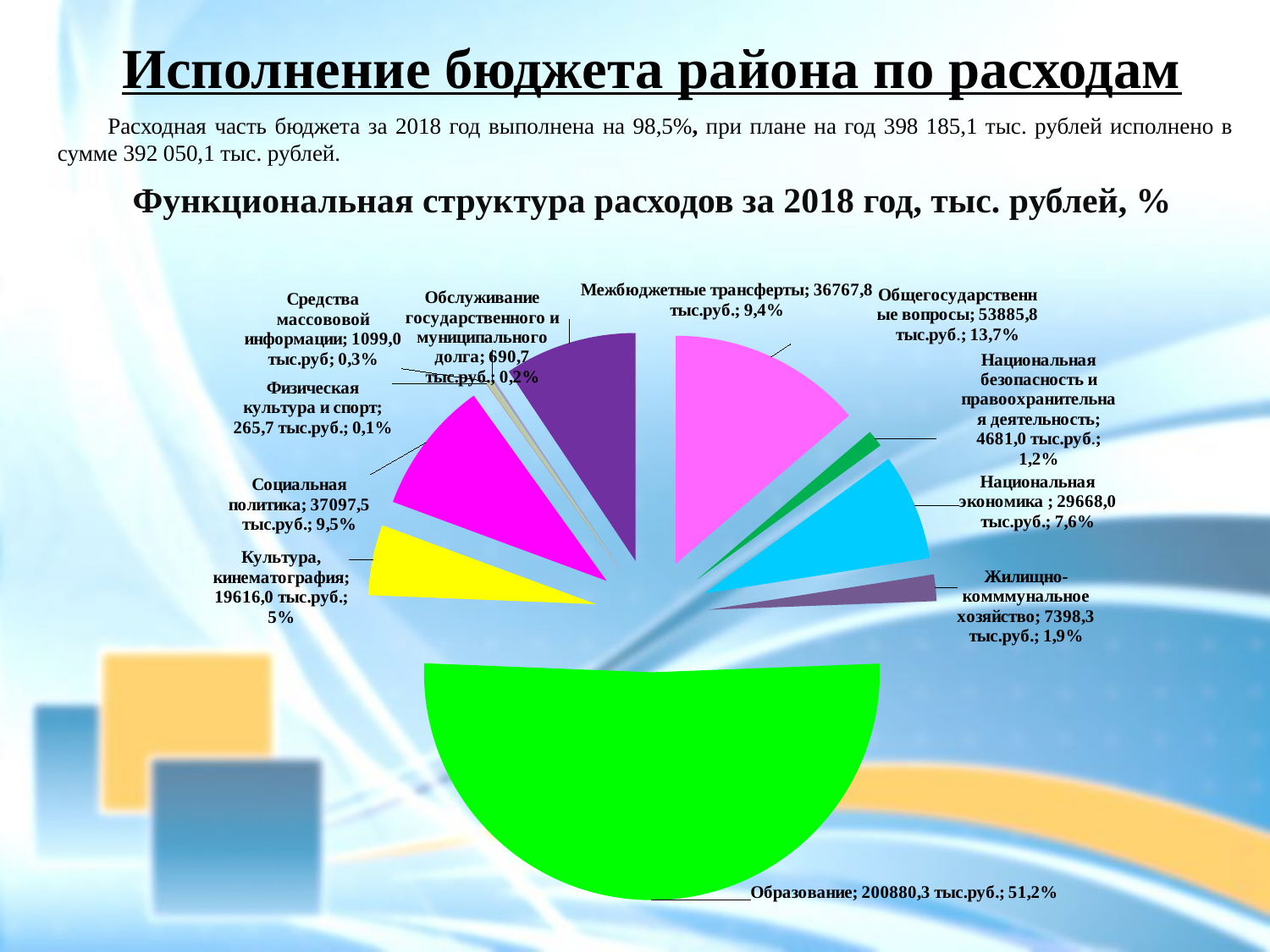
Which category has the smallest slice of the pie? Физическая культура и спорт What is the value for Образование in тыс.руб.? 200880,3 тыс.руб. What is the difference in percentage points between Общегосударственные вопросы (13,7%) and Национальная экономика (7,6%)? 6,1 What is the title of the chart? Функциональная структура расходов за 2018 год, тыс. рублей, % What kind of chart is shown on the slide? Pie chart What is the value for Национальная экономика in тыс.руб.? 29668,0 тыс.руб. What share of the pie does Общегосударственные вопросы represent? 13,7% Which is larger: Социальная политика or Межбюджетные трансферты? Социальная политика How many categories (slices) does the pie chart show? 11 What is the value for Культура, кинематография in тыс.руб.? 19616,0 тыс.руб. Which category has the largest slice of the pie? Образование What share of the pie does Жилищно-коммунальное хозяйство represent? 1,9%